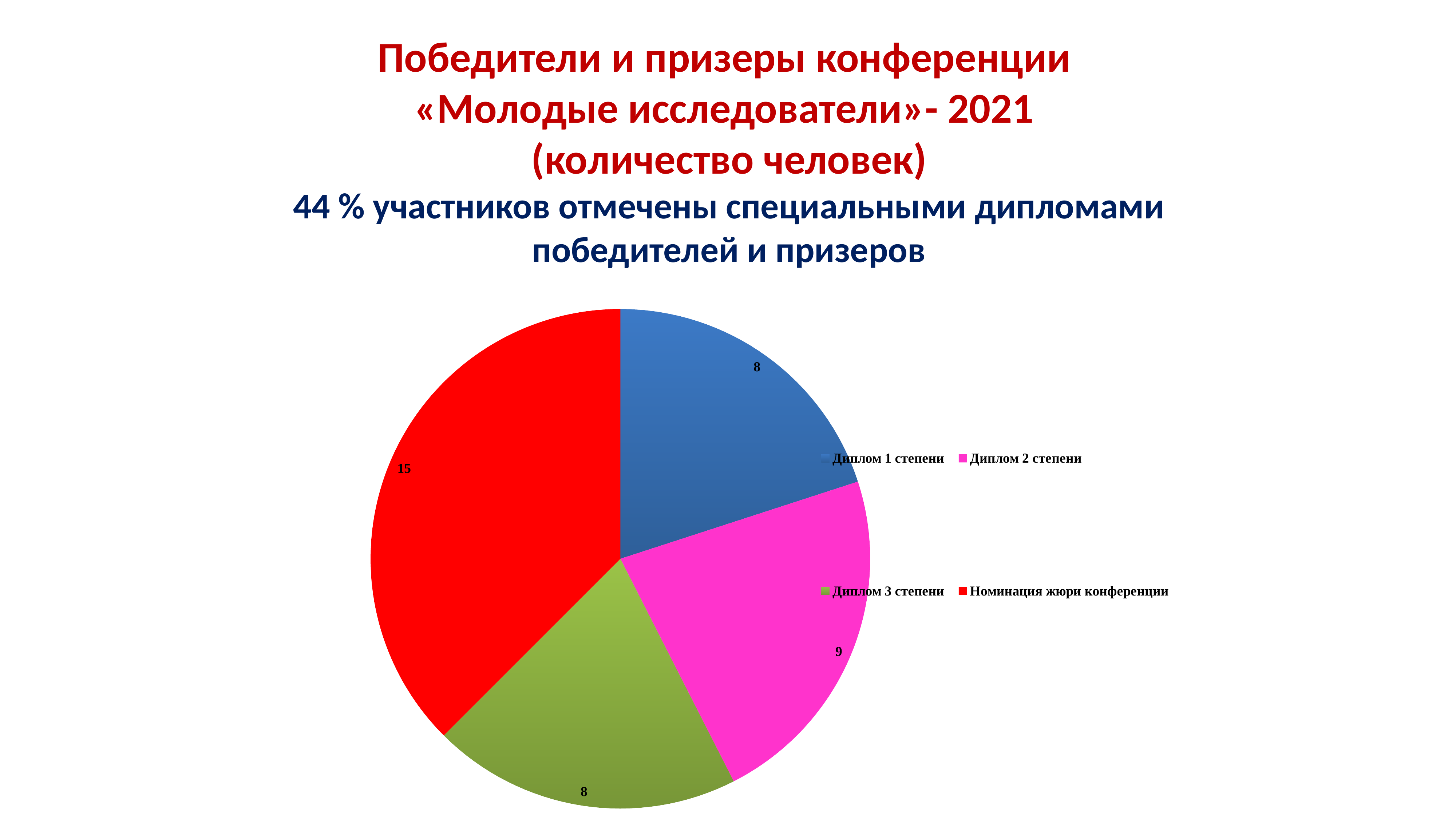
What kind of chart is shown on the slide? Pie chart What is the value for Номинация жюри конференции? 15 Which category has the largest slice of the pie? Номинация жюри конференции What share of the pie does Номинация жюри конференции represent? 37.5% What share of the pie does Диплом 1 степени represent? 20% What is the value for Диплом 1 степени? 8 What is the total of all slices in the pie chart? 40 What is the value for Диплом 2 степени? 9 Which is larger, the value for Диплом 2 степени or the value for Диплом 3 степени? Диплом 2 степени What colour is the slice for Диплом 3 степени? Green How many slices does the pie chart have? 4 What is the difference between the values for Номинация жюри конференции and Диплом 2 степени? 6